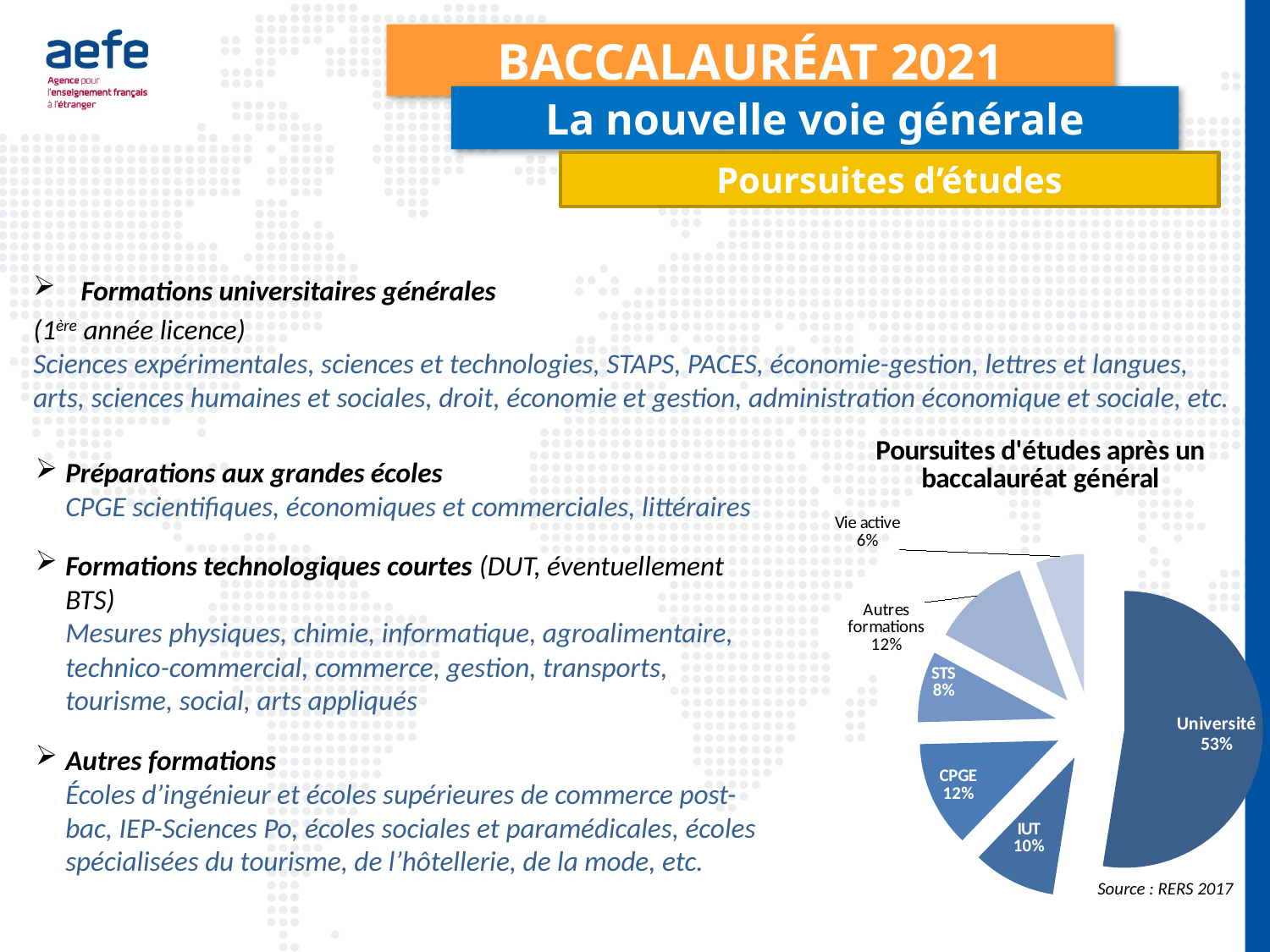
What is the value shown for IUT? 10% Which is larger, the share for STS or the share for IUT? IUT Which category has the largest slice of the pie? Université What is the value shown for CPGE? 12% What is the difference between the Université share and the CPGE share? 41% What is the title of the chart? Poursuites d'études après un baccalauréat général What is the value shown for Vie active? 6% Which category has the smallest slice of the pie? Vie active How many slices does the pie chart have? 6 What share of the pie does Université represent? 53% What is the value shown for STS? 8% What type of chart is shown on the slide? pie chart